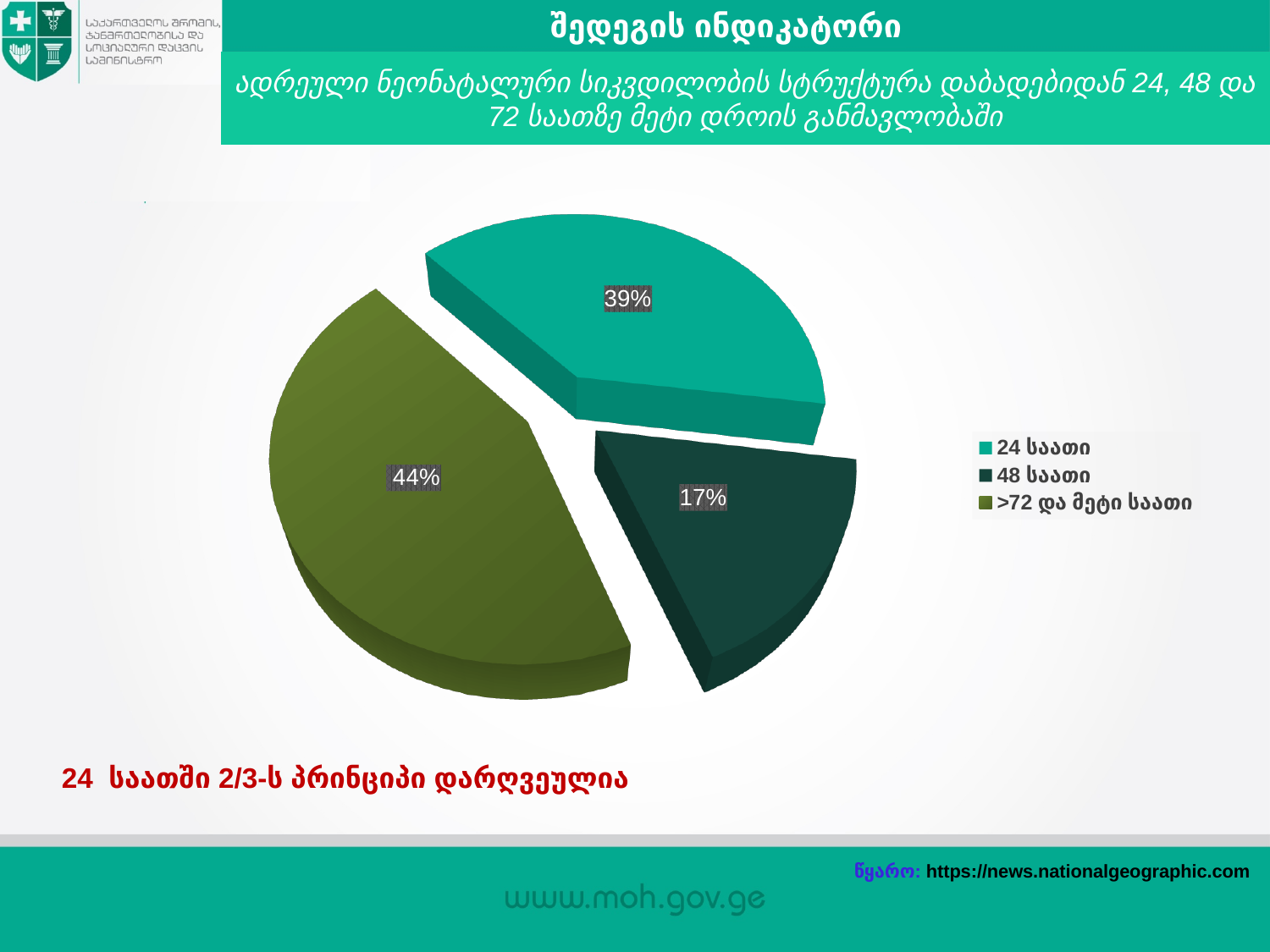
What colour is the "24 საათი" slice in the pie chart? teal What kind of chart is shown on the slide? pie chart What is the difference in percentage points between the ">72 და მეტი საათი" slice and the "24 საათი" slice? 5 What share of the pie does the ">72 და მეტი საათი" slice represent? 44% Which category has the largest slice of the pie? >72 და მეტი საათი What share of the pie does the "48 საათი" slice represent? 17% What share of the pie does the "24 საათი" slice represent? 39% What is the difference in percentage points between the "24 საათი" slice and the "48 საათი" slice? 22 How many slices does the pie chart have? 3 Which is larger, the "24 საათი" slice or the "48 საათი" slice? 24 საათი How many entries does the legend list? 3 Which category has the smallest slice of the pie? 48 საათი